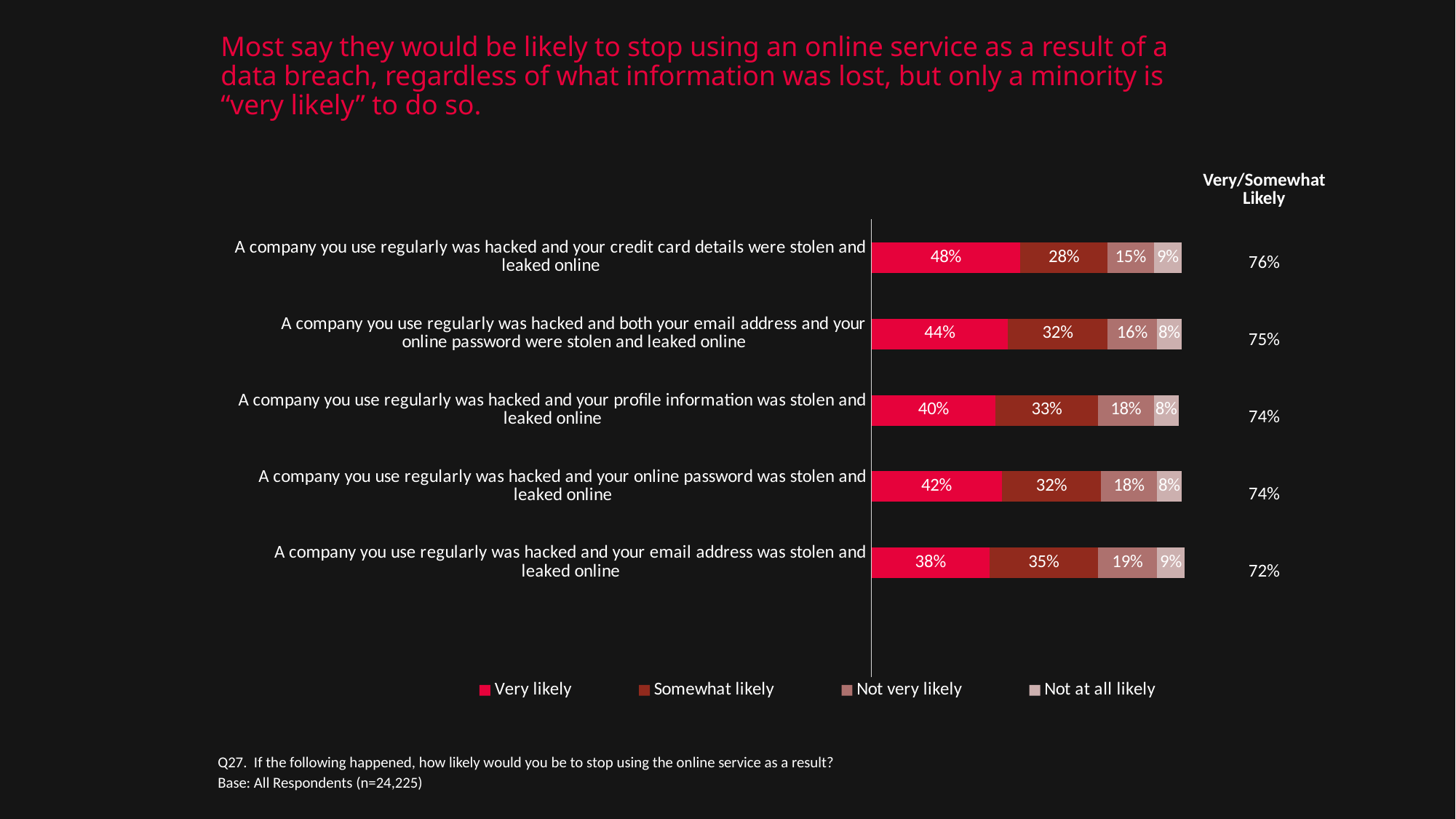
What percentage said they were "Somewhat likely" to stop using the service if their email address was stolen and leaked online? 35% What percentage said they were "Not very likely" to stop using the service if their profile information was stolen and leaked online? 18% What is the difference between the "Very likely" percentages for the credit card details scenario and the email address scenario? 10% What kind of chart is shown on the slide? Stacked bar chart What is the name of the fourth series in the legend? Not at all likely Which scenario has the highest "Very likely" percentage? Credit card details were stolen and leaked online What percentage said they were "Very likely" to stop using the service if their credit card details were stolen and leaked online? 48% Which is larger: the "Very likely" share for the online password scenario or for the profile information scenario? Online password scenario (42%) How many scenarios (categories) are plotted in the chart? 5 Which scenario has the lowest "Very likely" percentage? Email address was stolen and leaked online What is the combined Very/Somewhat Likely percentage for the scenario where both email address and online password were stolen and leaked online? 75% How many series does the legend list? 4